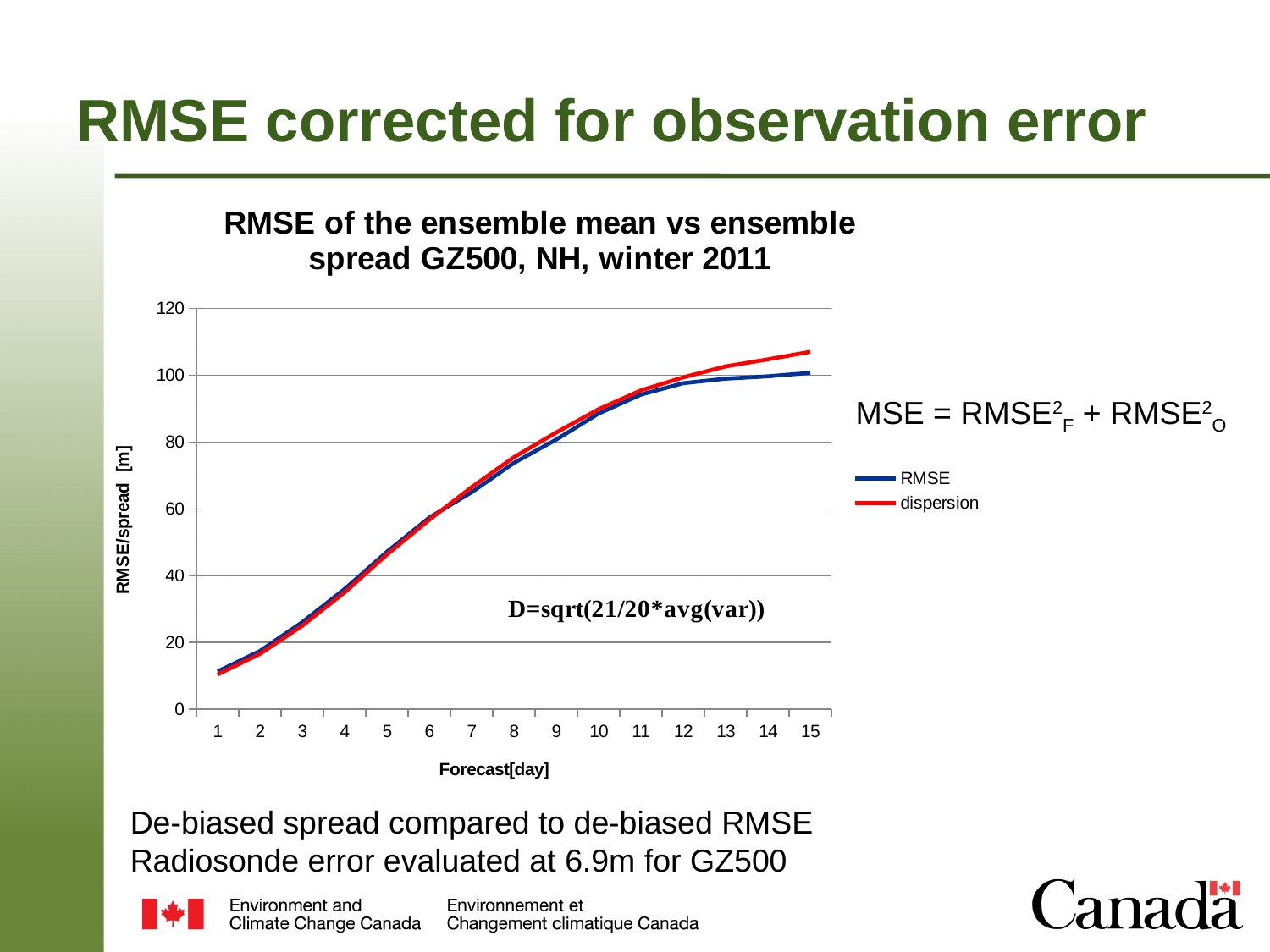
How many series does the chart legend list? 2 What kind of chart is shown on the slide? line chart What is the label of the chart's x axis? Forecast[day] At which forecast day is the dispersion value highest? 15 What are the two series named in the chart legend? RMSE and dispersion At which forecast day is the RMSE value lowest? 1 Is the RMSE value at forecast day 1 greater or less than 20? less Is the dispersion value at forecast day 15 greater or less than 100? greater How many forecast days are plotted along the x axis? 15 Do the RMSE values rise or fall as the forecast day increases? rise At forecast day 15, which series has the larger value, RMSE or dispersion? dispersion Is the RMSE value at forecast day 8 greater or less than 80? less